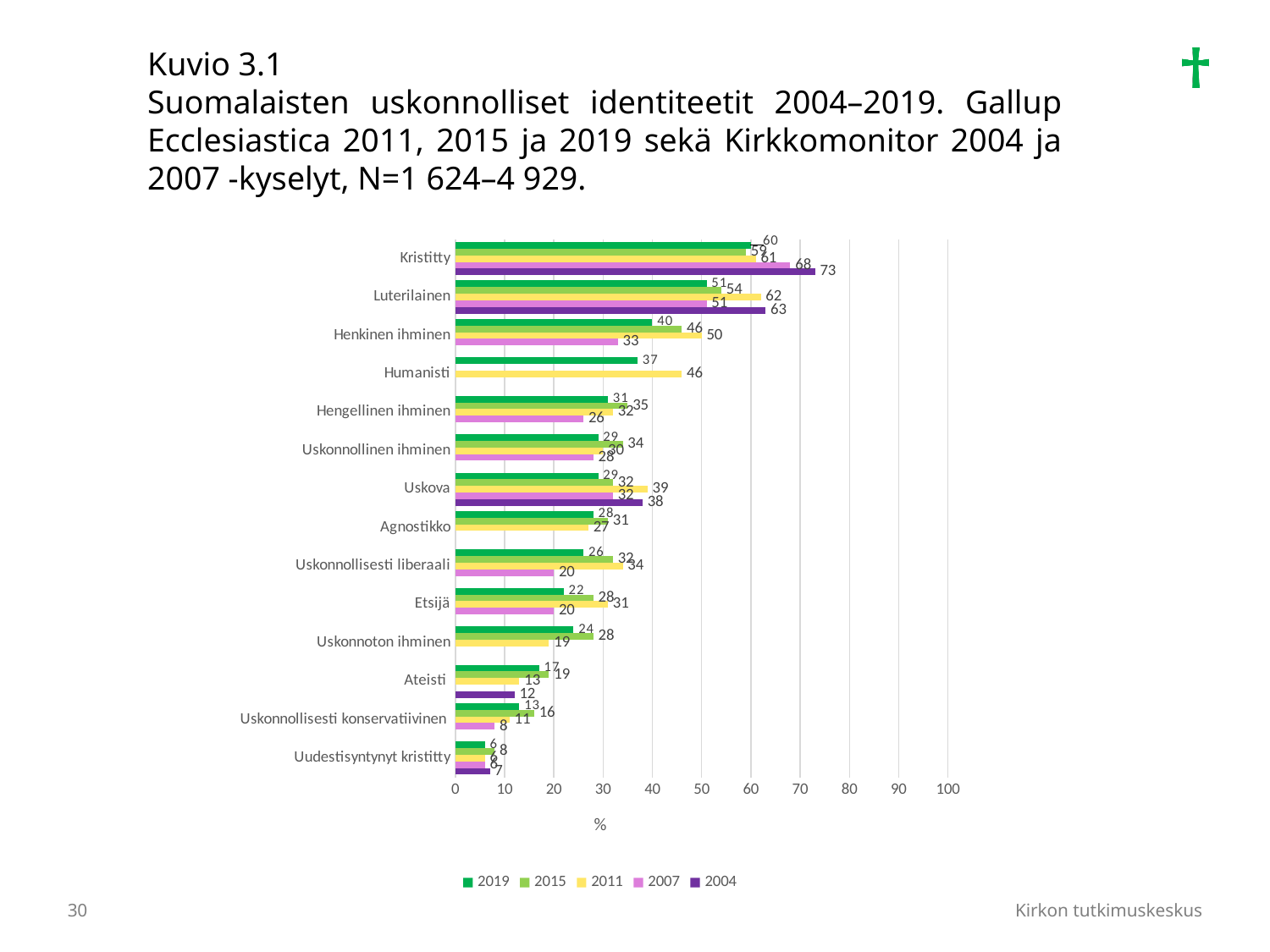
What is the 2011 value for Luterilainen? 62 How many categories are shown on the y axis of the chart? 14 Is the 2019 value for Etsijä greater or less than 30? less What is the difference between the 2004 and 2019 values for Kristitty? 13 What is the 2007 value for Henkinen ihminen? 33 What is the 2019 value for Humanisti? 37 What is the label on the horizontal axis of the chart? % Which is larger in 2011: Luterilainen or Henkinen ihminen? Luterilainen How many series does the legend list? 5 What is the 2004 value for Kristitty? 73 What kind of chart is shown on the slide? bar chart Which category has the highest value in the 2019 series? Kristitty